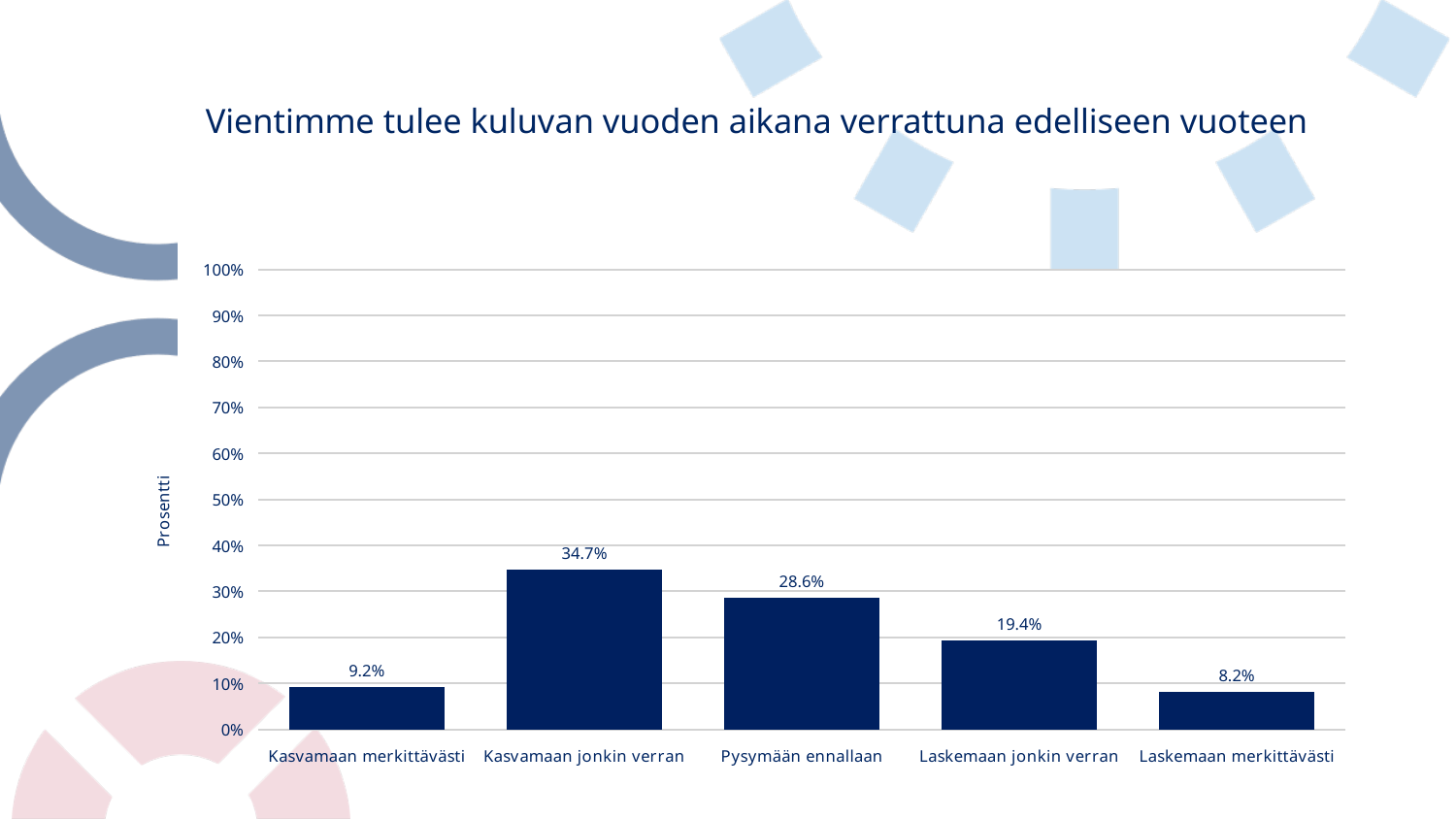
Which category has the highest value? Kasvamaan jonkin verran What is the value for "Pysymään ennallaan"? 28.6% What is the value for "Kasvamaan jonkin verran"? 34.7% How many categories are shown on the x axis? 5 Is the value for "Laskemaan jonkin verran" greater or less than 30%? less Which category has the lowest value? Laskemaan merkittävästi What is the difference between the values for "Kasvamaan jonkin verran" and "Pysymään ennallaan"? 6.1% What is the label of the vertical axis? Prosentti Which is larger, the value for "Kasvamaan merkittävästi" or "Laskemaan jonkin verran"? Laskemaan jonkin verran What is the title of the chart? Vientimme tulee kuluvan vuoden aikana verrattuna edelliseen vuoteen What is the value for "Laskemaan merkittävästi"? 8.2% What kind of chart is shown on the slide? bar chart